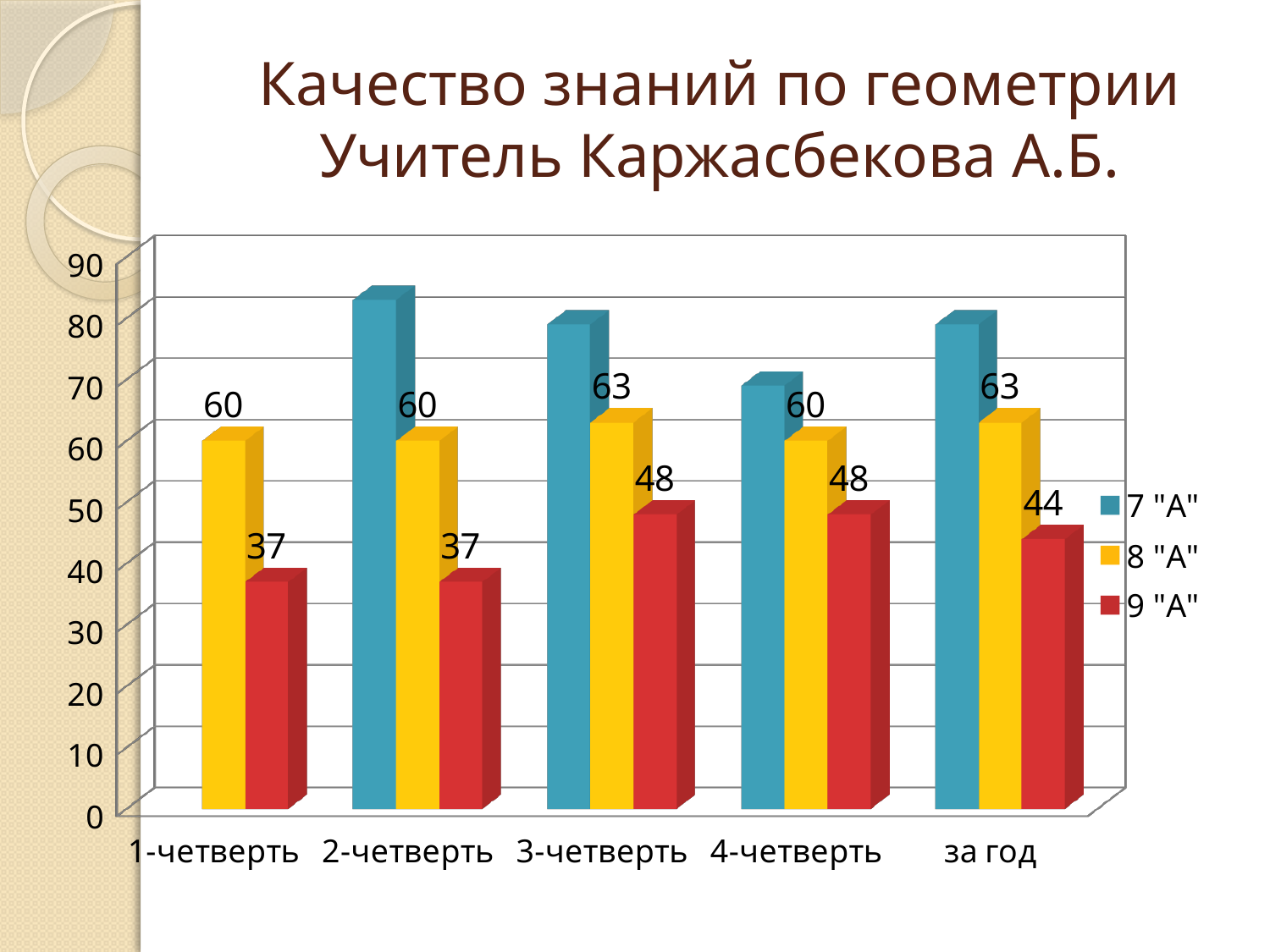
What is the value for 9 "А" for за год? 44 What is the difference between the 8 "А" and 9 "А" values in 2-четверть? 23 How many categories are shown on the x axis? 5 How many series does the legend list? 3 Is the value for 7 "А" in 3-четверть greater or less than 70? greater Which is larger in 4-четверть: the value for 8 "А" or for 9 "А"? 8 "А" In which category is the value for 9 "А" lowest? 1-четверть and 2-четверть (37) Is the value for 7 "А" in 4-четверть greater or less than 60? greater What is the value for 9 "А" in 3-четверть? 48 What is the value for 8 "А" in 1-четверть? 60 What kind of chart is shown on the slide? Bar chart What is the value for 8 "А" for за год? 63